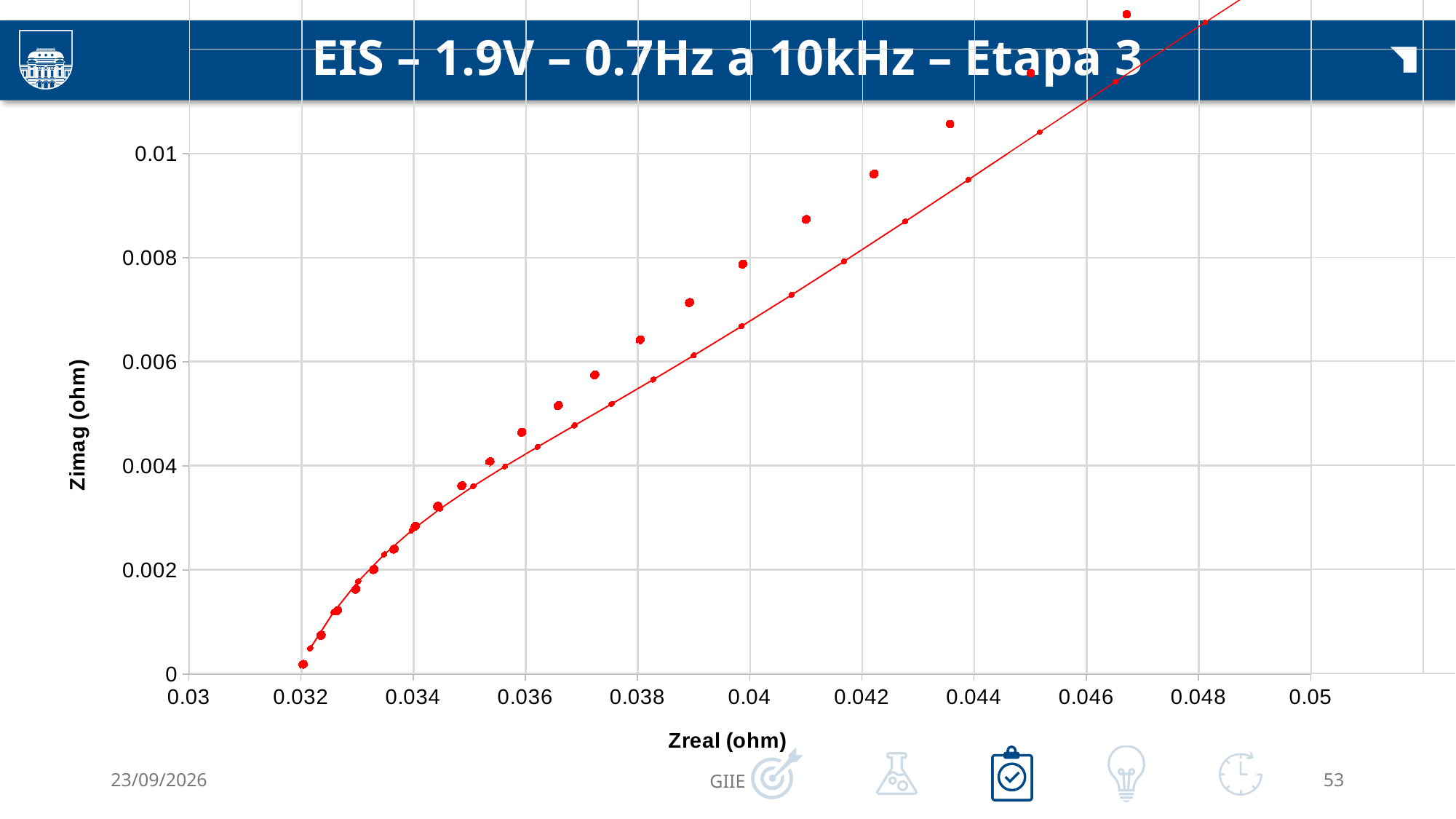
What kind of chart is shown on the slide? scatter chart with a fitted line Is the Zimag value at Zreal = 0.044 greater or less than 0.008? greater Is the Zimag value at Zreal = 0.034 greater or less than 0.004? less As Zreal increases along the x axis, does Zimag rise or fall? rise Is the Zimag value at Zreal = 0.032 greater or less than 0.002? less What is the title of the chart? EIS – 1.9V – 0.7Hz a 10kHz – Etapa 3 What is the label of the x axis? Zreal (ohm)